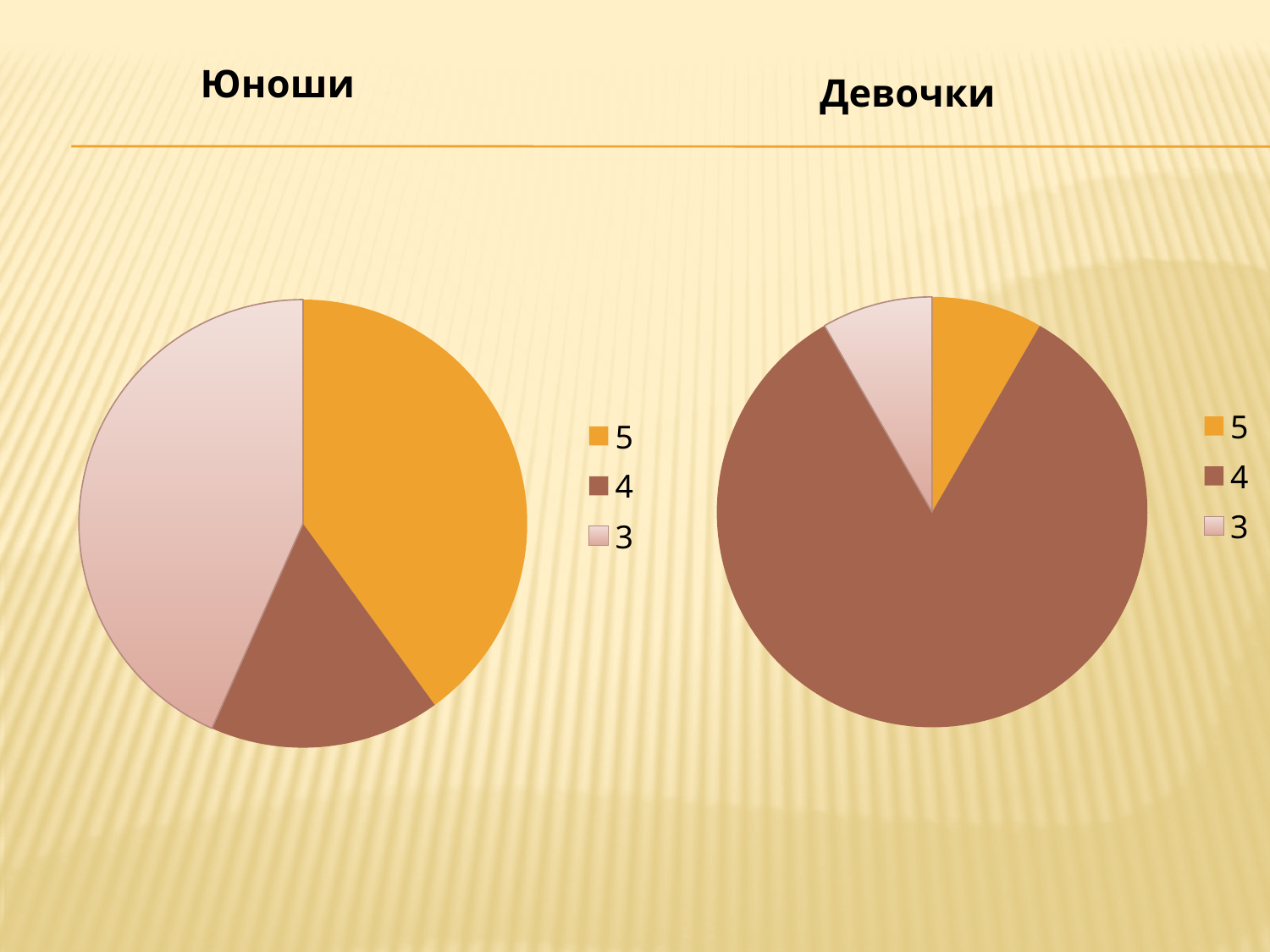
In the "Девочки" chart, which category has the largest slice? 4 What kind of chart is the "Юноши" chart? pie chart In the "Юноши" chart, how many slices does the pie have? 3 In the "Юноши" chart, which slice is larger, 3 or 4? 3 In the "Девочки" chart, which slice is larger, 3 or 4? 4 In the "Девочки" chart, what colour is the slice for category 5? orange In the "Юноши" chart, which category has the smallest slice? 4 In the "Девочки" chart, how many categories does the legend list? 3 What kind of chart is the "Девочки" chart? pie chart In the "Юноши" chart, which slice is larger, 5 or 4? 5 What are the legend entries of the "Юноши" chart? 5, 4, 3